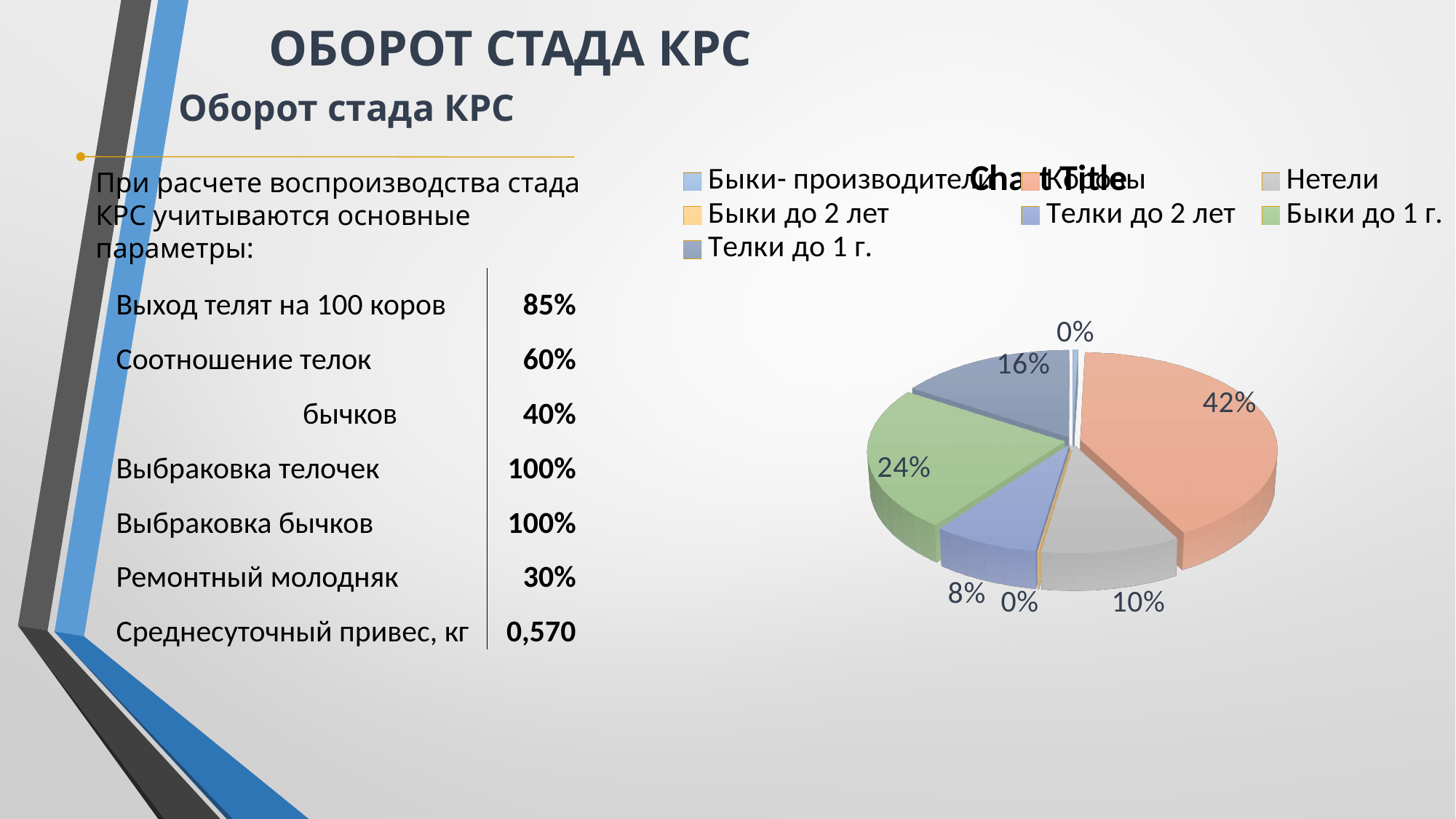
What share of the pie does Телки до 1 г. have? 16% What share of the pie does Быки- производители have? 0% Which category has the largest slice of the pie? Коровы What colour is the Коровы slice in the pie chart? orange What share of the pie does Нетели have? 10% What share of the pie does Телки до 2 лет have? 8% What kind of chart is shown on the slide? pie chart What share of the pie does Быки до 1 г. have? 24% What is the difference in percentage points between the Коровы slice and the Быки до 1 г. slice? 18 How many categories does the pie chart's legend list? 7 Which slice is larger, Быки до 1 г. or Телки до 1 г.? Быки до 1 г. What share of the pie does Коровы have? 42%